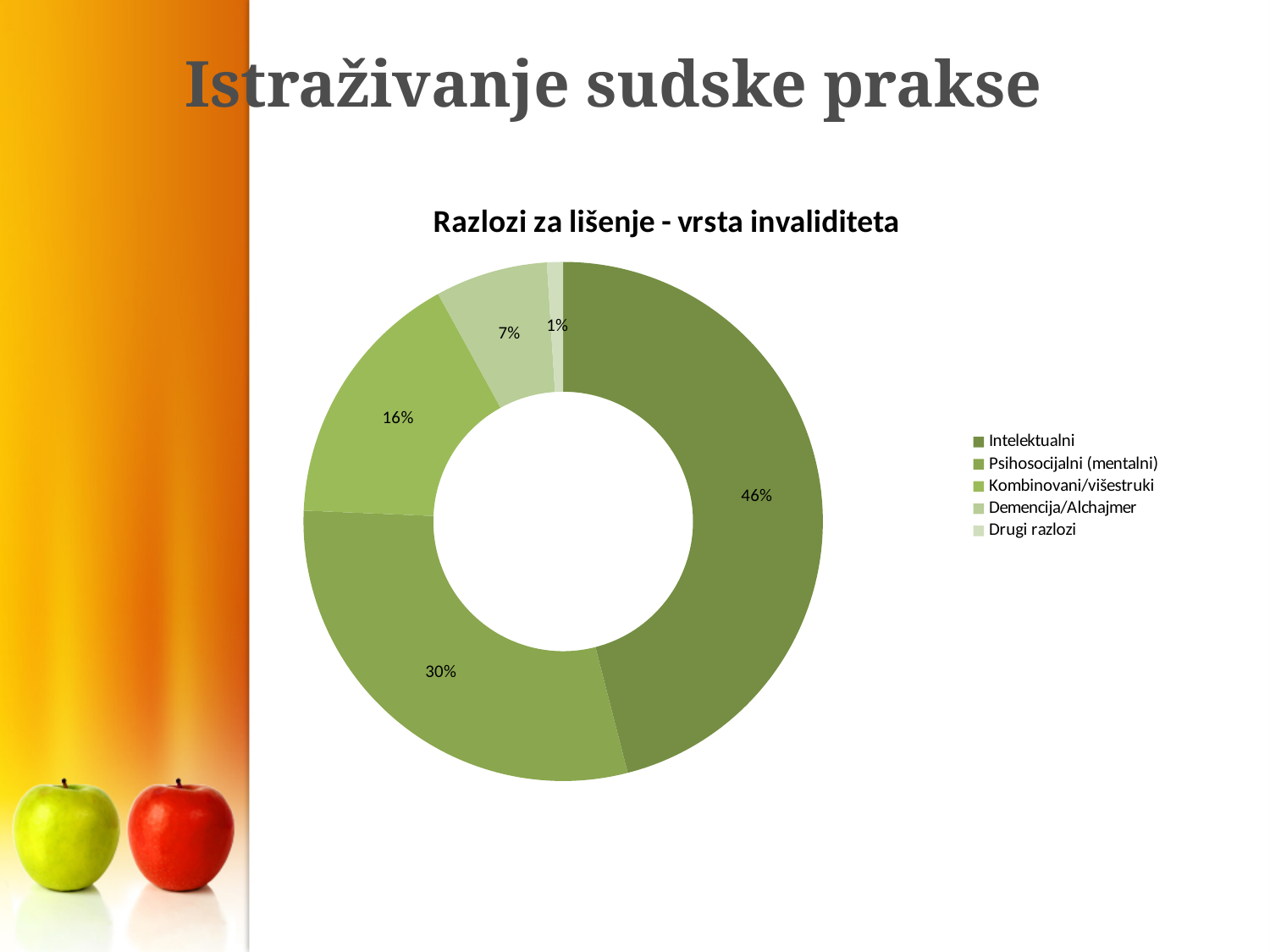
What is the title of the chart? Razlozi za lišenje - vrsta invaliditeta What kind of chart is shown on the slide? Doughnut chart Which category has the smallest share of the chart? Drugi razlozi What percentage is shown for Demencija/Alchajmer? 7% What is the difference in percentage points between Intelektualni and Psihosocijalni (mentalni)? 16 What percentage is shown for Intelektualni? 46% How many categories does the legend list? 5 Which category has the largest share of the chart? Intelektualni What percentage is shown for Psihosocijalni (mentalni)? 30% Which is larger, the share for Kombinovani/višestruki or the share for Demencija/Alchajmer? Kombinovani/višestruki What percentage is shown for Drugi razlozi? 1% What percentage is shown for Kombinovani/višestruki? 16%